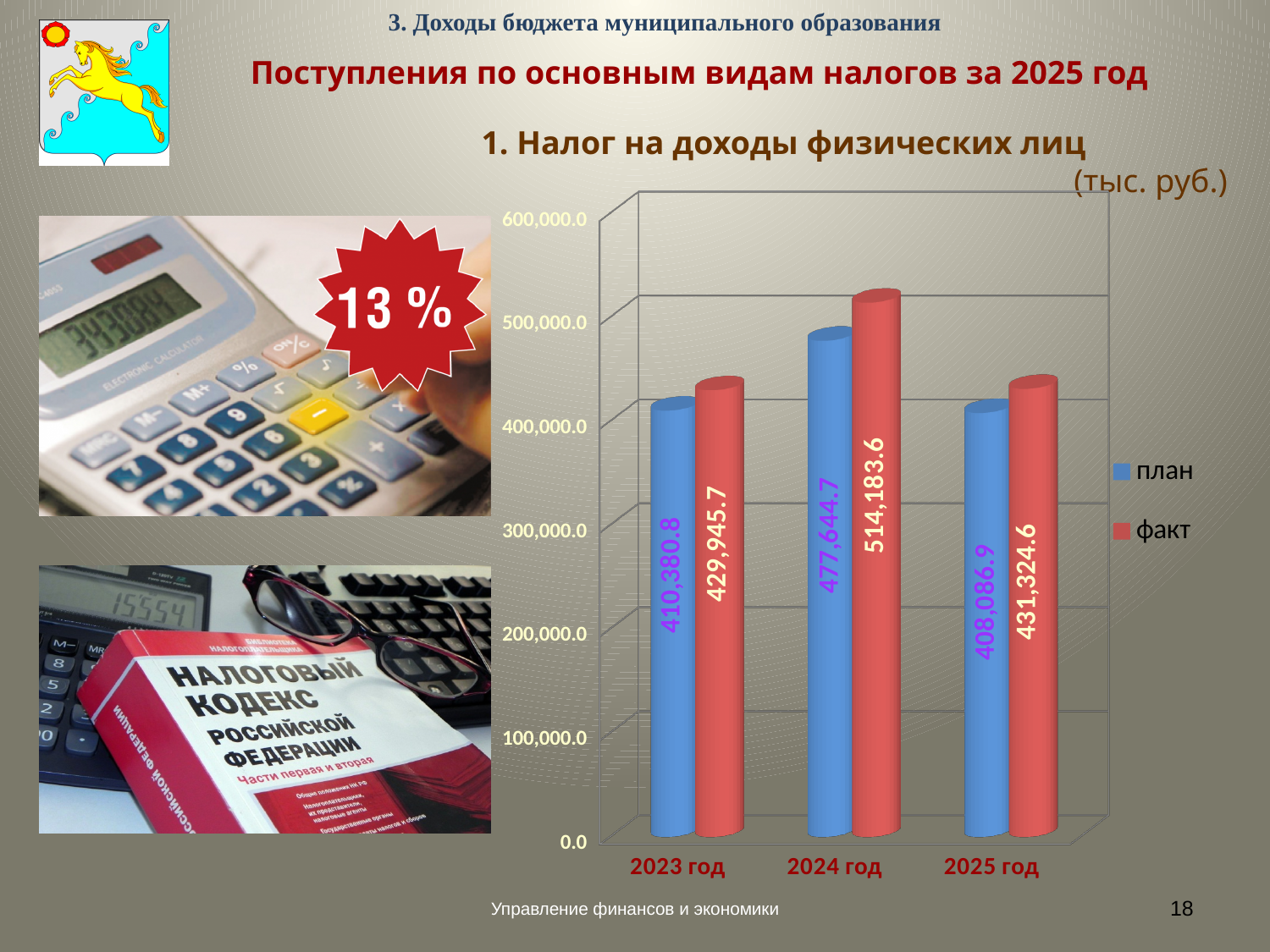
What is the difference between факт and план for 2023 год? 19,564.9 Which year has the lowest план value? 2025 год How many years are shown on the x axis? 3 How many series does the legend list? 2 Which is larger for 2025 год, план or факт? факт What is the факт value for 2025 год? 431,324.6 What is the difference between факт and план for 2024 год? 36,538.9 What kind of chart is shown on the slide? bar chart Which year has the highest факт value? 2024 год Is the факт value for 2024 год greater or less than 500,000.0? greater What is the план value for 2024 год? 477,644.7 What is the план value for 2023 год? 410,380.8